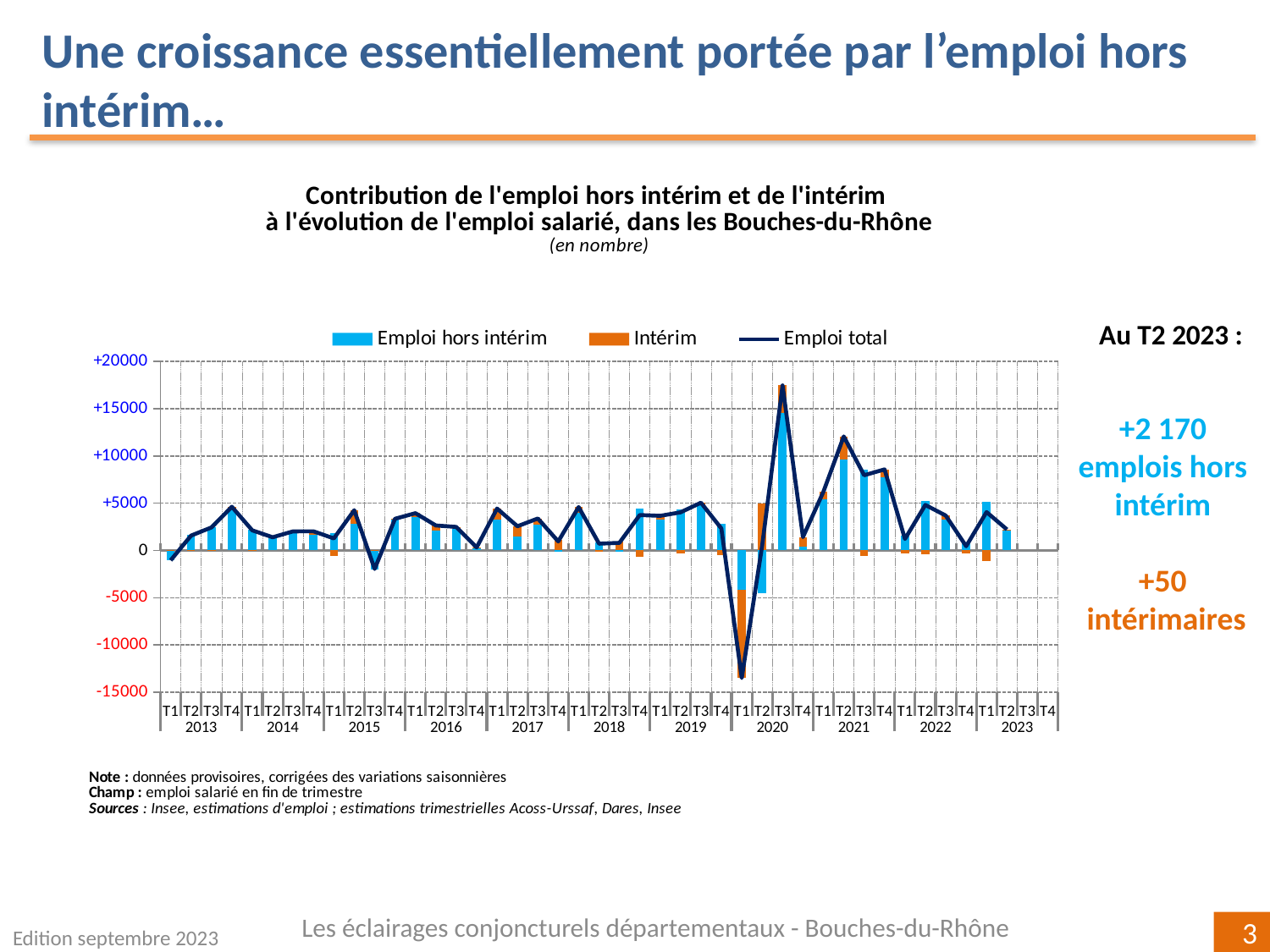
Is the Emploi total value at T3 2020 greater or less than 15000? greater What is the difference between Emploi hors intérim and Intérim at T2 2023? 2 120 Is the Emploi total value at T1 2020 greater or less than -10000? less In which quarter does the Emploi total line reach its lowest point? T1 2020 What colour are the Intérim bars in the chart? Orange Does the Emploi total line rise or fall from T1 2020 to T3 2020? rise In which quarter does the Emploi total line reach its highest point? T3 2020 What is the value for Emploi hors intérim at T2 2023? +2 170 What kind of chart is shown on the slide? Combined bar and line chart What is the value for Intérim at T2 2023? +50 How many series does the chart legend list? 3 At T2 2023, which is larger: Emploi hors intérim or Intérim? Emploi hors intérim